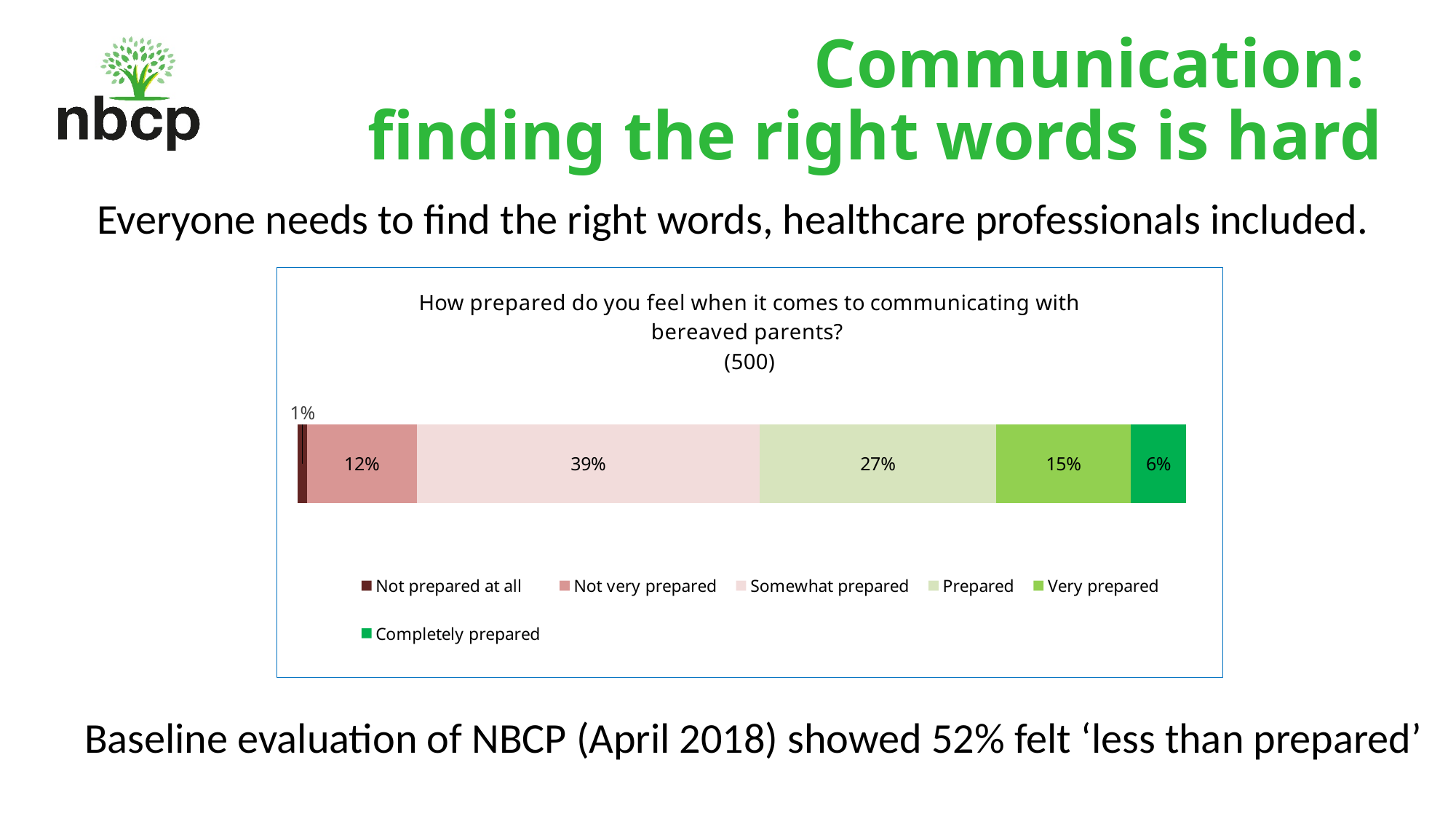
What percentage of respondents said they were 'Very prepared'? 15% What sample size is shown in the chart title? 500 What percentage of respondents said they were 'Somewhat prepared'? 39% How many series does the legend list? 6 What percentage of respondents said they were 'Completely prepared'? 6% Which is larger, the share for 'Very prepared' or the share for 'Not very prepared'? Very prepared What is the combined percentage of 'Not prepared at all', 'Not very prepared' and 'Somewhat prepared'? 52% What percentage of respondents said they were 'Not very prepared'? 12% What is the difference between the 'Somewhat prepared' and 'Prepared' percentages? 12% Which response category has the smallest share? Not prepared at all What kind of chart is shown on the slide? Stacked bar chart Which response category has the largest share? Somewhat prepared